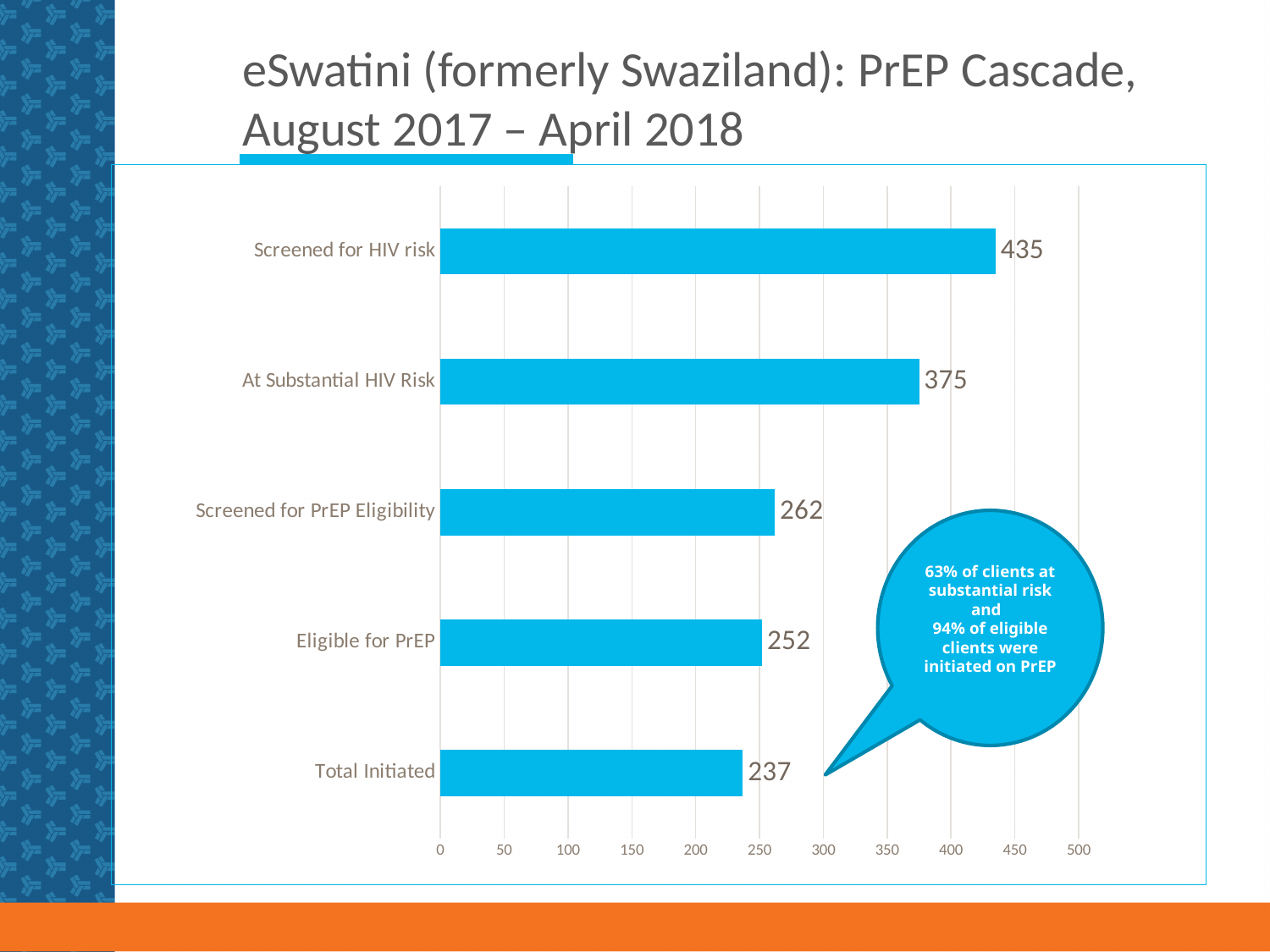
What is the difference between Eligible for PrEP and Total Initiated? 15 What is the difference between Screened for HIV risk and At Substantial HIV Risk? 60 What kind of chart is shown on the slide? Bar chart How many categories are shown in the chart? 5 Which category has the highest value? Screened for HIV risk What is the value for At Substantial HIV Risk? 375 According to the callout on the chart, what percentage of eligible clients were initiated on PrEP? 94% What is the value for Total Initiated? 237 What is the value for Eligible for PrEP? 252 Which is larger, Screened for PrEP Eligibility or Eligible for PrEP? Screened for PrEP Eligibility Which category has the lowest value? Total Initiated What is the value for Screened for HIV risk? 435